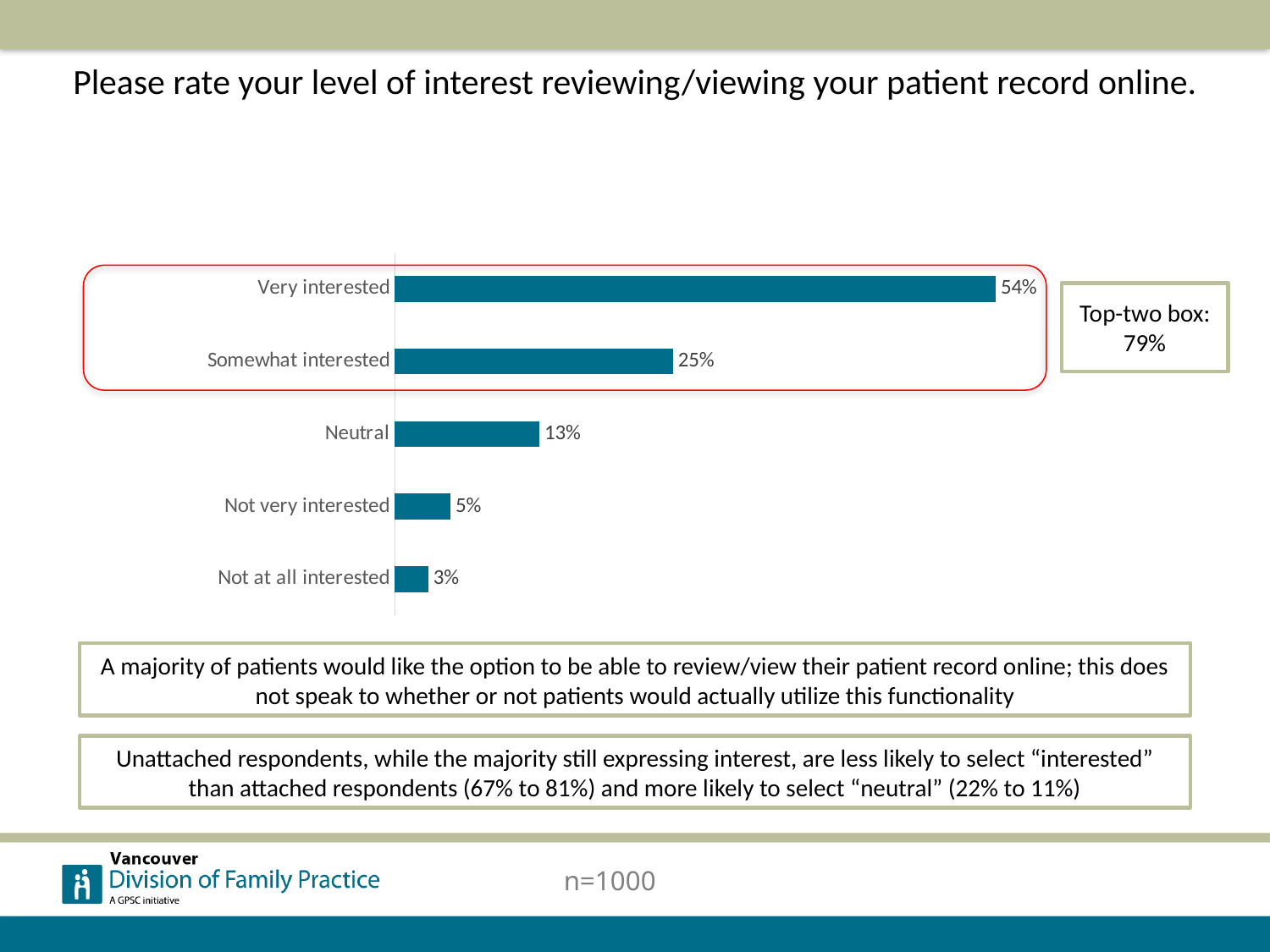
How many categories are shown in the chart? 5 Which is larger, the value for "Neutral" or the value for "Not very interested"? Neutral What percentage of respondents were not at all interested? 3% What percentage of respondents selected "Somewhat interested"? 25% What top-two box percentage is shown next to the chart? 79% What type of chart is shown on the slide? Bar chart What percentage of respondents said they were very interested in reviewing/viewing their patient record online? 54% Which category has the highest percentage? Very interested What is the difference in percentage points between "Not very interested" and "Not at all interested"? 2 Which category has the lowest percentage? Not at all interested What is the value shown for the "Neutral" category? 13% What is the difference in percentage points between "Very interested" and "Somewhat interested"? 29